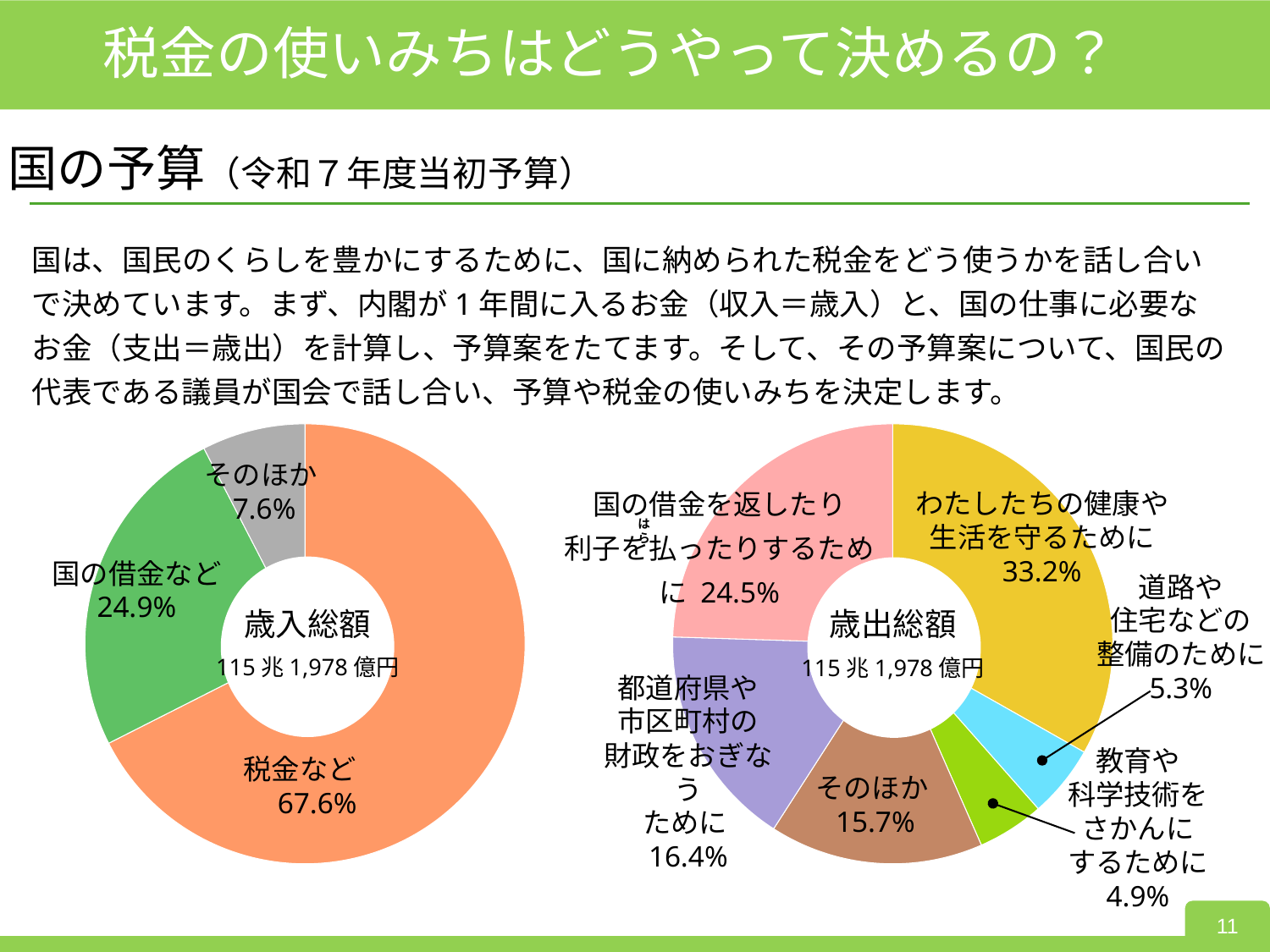
In the left chart (歳入総額), how many categories are shown? 3 In the left chart (歳入総額), what share is labelled for 税金など? 67.6% What total amount is printed in the centre of the left chart (歳入総額)? 115兆1,978億円 In the left chart (歳入総額), what is the difference between the shares of 税金など and 国の借金など? 42.7% In the right chart (歳出総額), what share is labelled for わたしたちの健康や生活を守るために? 33.2% In the right chart (歳出総額), what share is labelled for 教育や科学技術をさかんにするために? 4.9% In the left chart (歳入総額), what share is labelled for 国の借金など? 24.9% What kind of chart is used on this slide? Pie (donut) chart In the right chart (歳出総額), which category has the largest share? わたしたちの健康や生活を守るために In the right chart (歳出総額), which is larger: 都道府県や市区町村の財政をおぎなうために or 国の借金を返したり利子を払ったりするために? 国の借金を返したり利子を払ったりするために In the right chart (歳出総額), how many categories are shown? 6 In the left chart (歳入総額), which category has the smallest share? そのほか